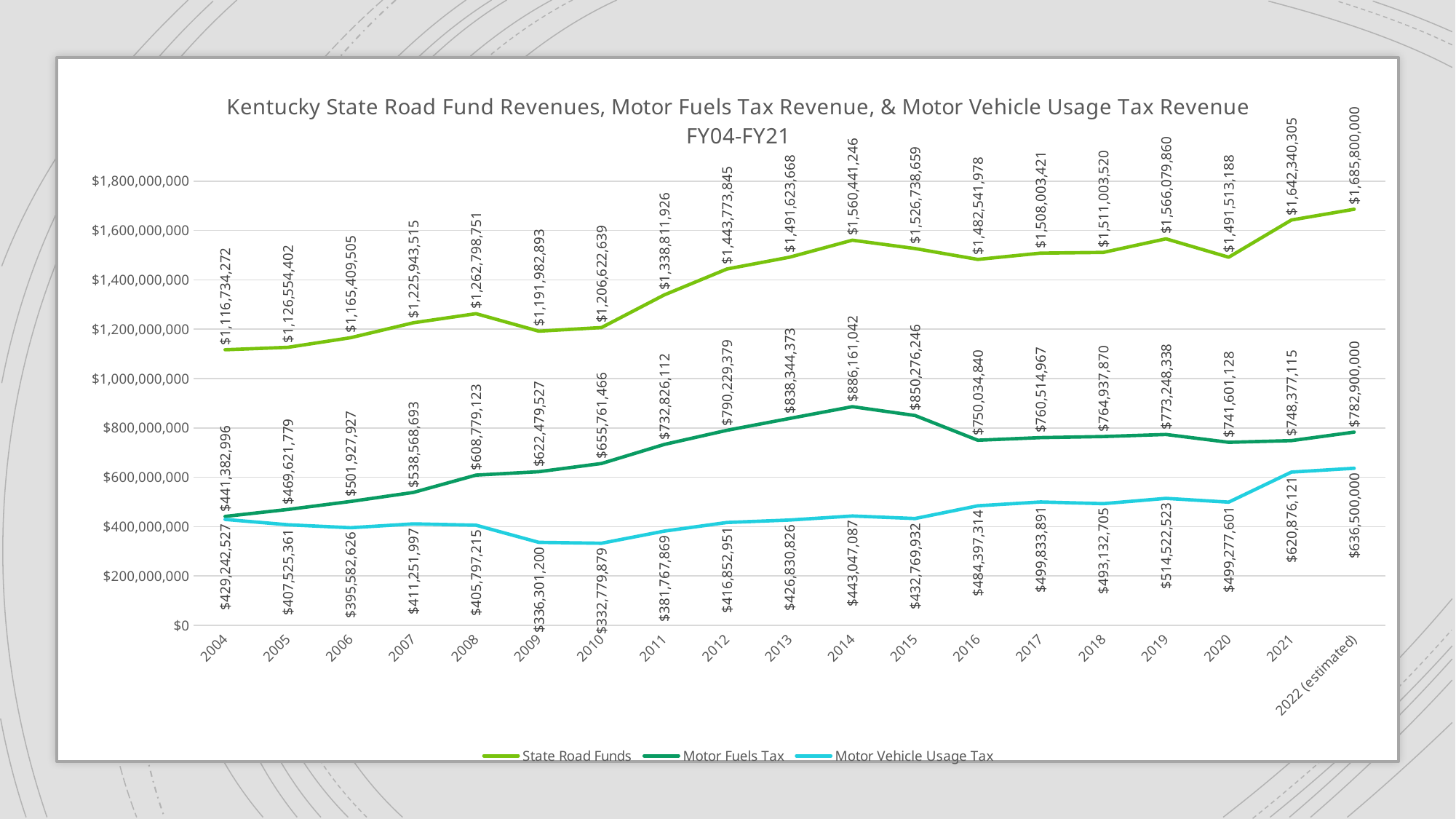
Which was larger in 2021: Motor Fuels Tax revenue or Motor Vehicle Usage Tax revenue? Motor Fuels Tax Overall, does the State Road Funds series rise or fall from 2004 to 2022 (estimated)? Rise In which year did the Motor Fuels Tax series reach its highest value? 2014 What kind of chart is shown on the slide? Line chart In which year was the Motor Vehicle Usage Tax revenue lowest? 2010 What was the State Road Funds value in 2014? $1,560,441,246 How many series does the legend list? 3 What was the Motor Vehicle Usage Tax revenue in 2019? $514,522,523 What is the estimated Motor Fuels Tax revenue for 2022? $782,900,000 What was the Motor Fuels Tax revenue in 2010? $655,761,466 How much higher was Motor Fuels Tax revenue in 2014 than in 2004? $444,778,046 How many years (data points) are plotted along the x axis? 19